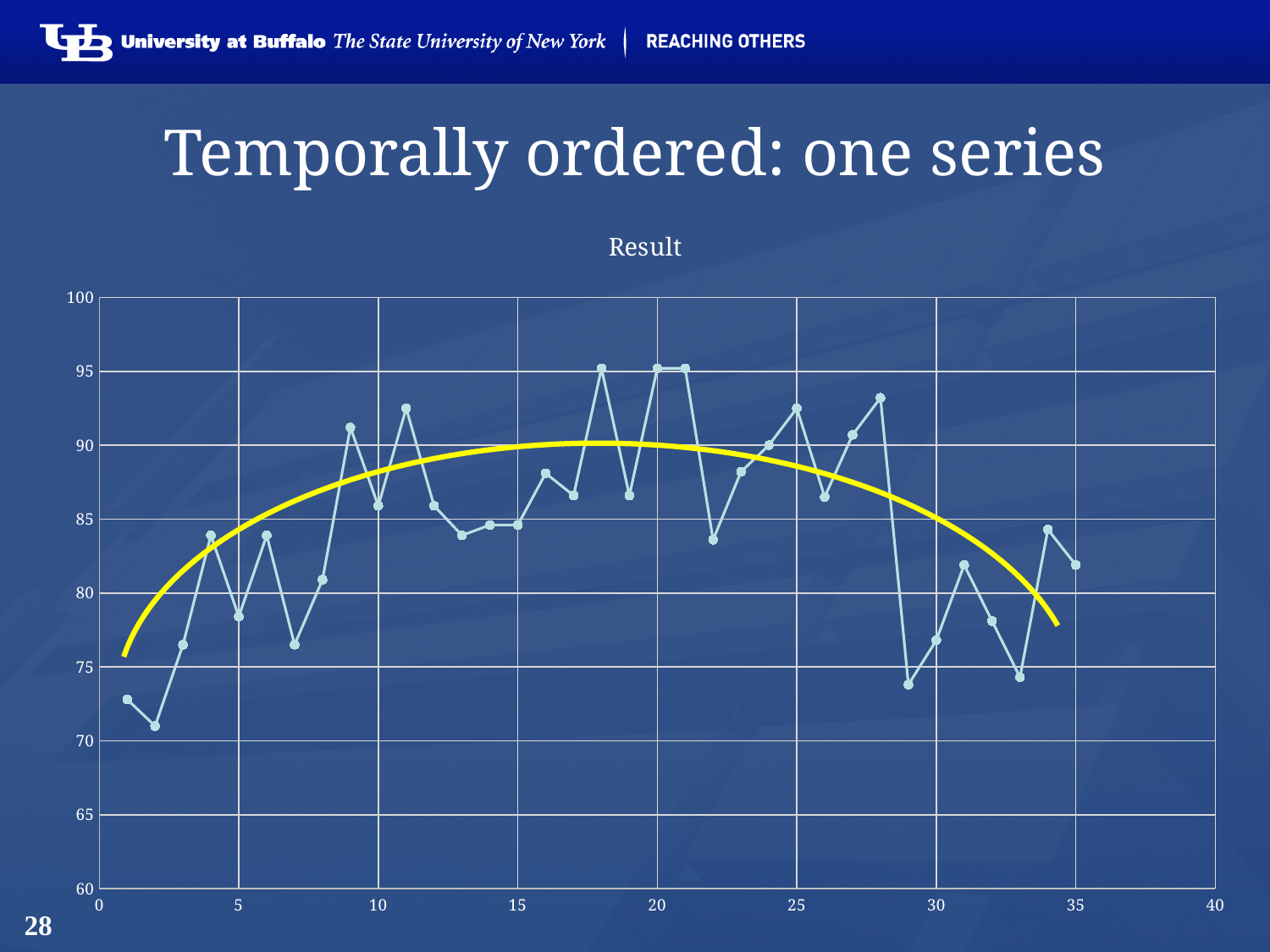
Which has the larger value, the point at x = 18 or the point at x = 2? x = 18 How many data points are plotted in the series? 35 What kind of chart is shown on the slide? line chart What colour is the smooth fitted curve drawn over the data? yellow Is the value at x = 29 greater or less than 75? less At which x value does the series reach its lowest point? 2 Is the value at x = 28 greater or less than 90? greater Is the value at x = 18 greater or less than 90? greater What is the title of the chart? Result Describe the overall trend of the fitted curve along the x axis. rises then falls